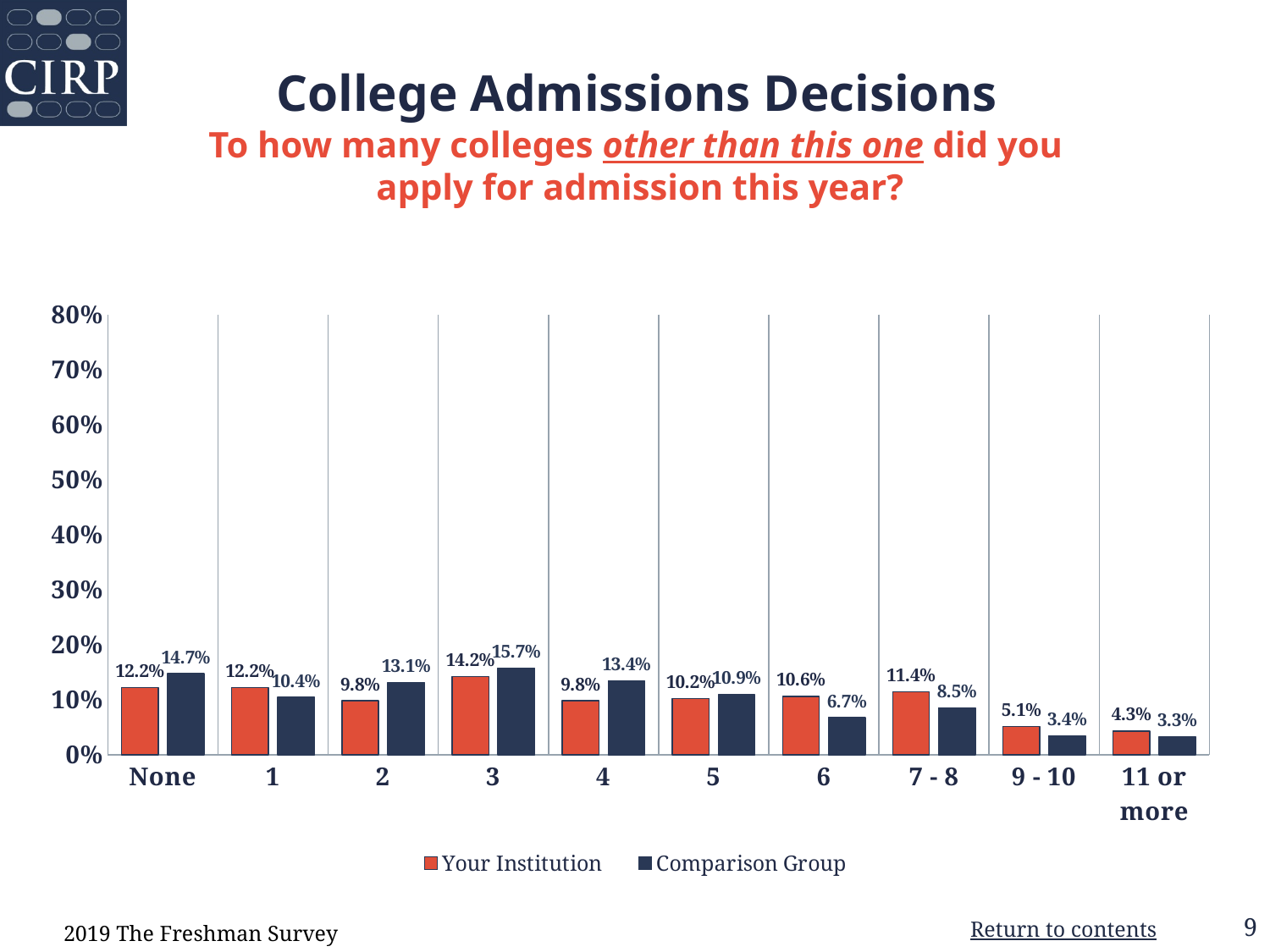
How many categories are shown on the x axis? 10 Is the value for Your Institution in the "7 - 8" category greater or less than 10%? greater What is the value for the Comparison Group in the "None" category? 14.7% Which series is shown in dark navy bars? Comparison Group Which category has the highest value for the Comparison Group? 3 What kind of chart is shown on the slide? Bar chart What is the value for Your Institution in the "3" category? 14.2% How many series does the legend list? 2 What is the difference between the Comparison Group and Your Institution values in the "6" category? 3.9 percentage points In the "2" category, which series has the larger value, Your Institution or Comparison Group? Comparison Group What is the value for Your Institution in the "9 - 10" category? 5.1% Which category has the lowest value for Your Institution? 11 or more